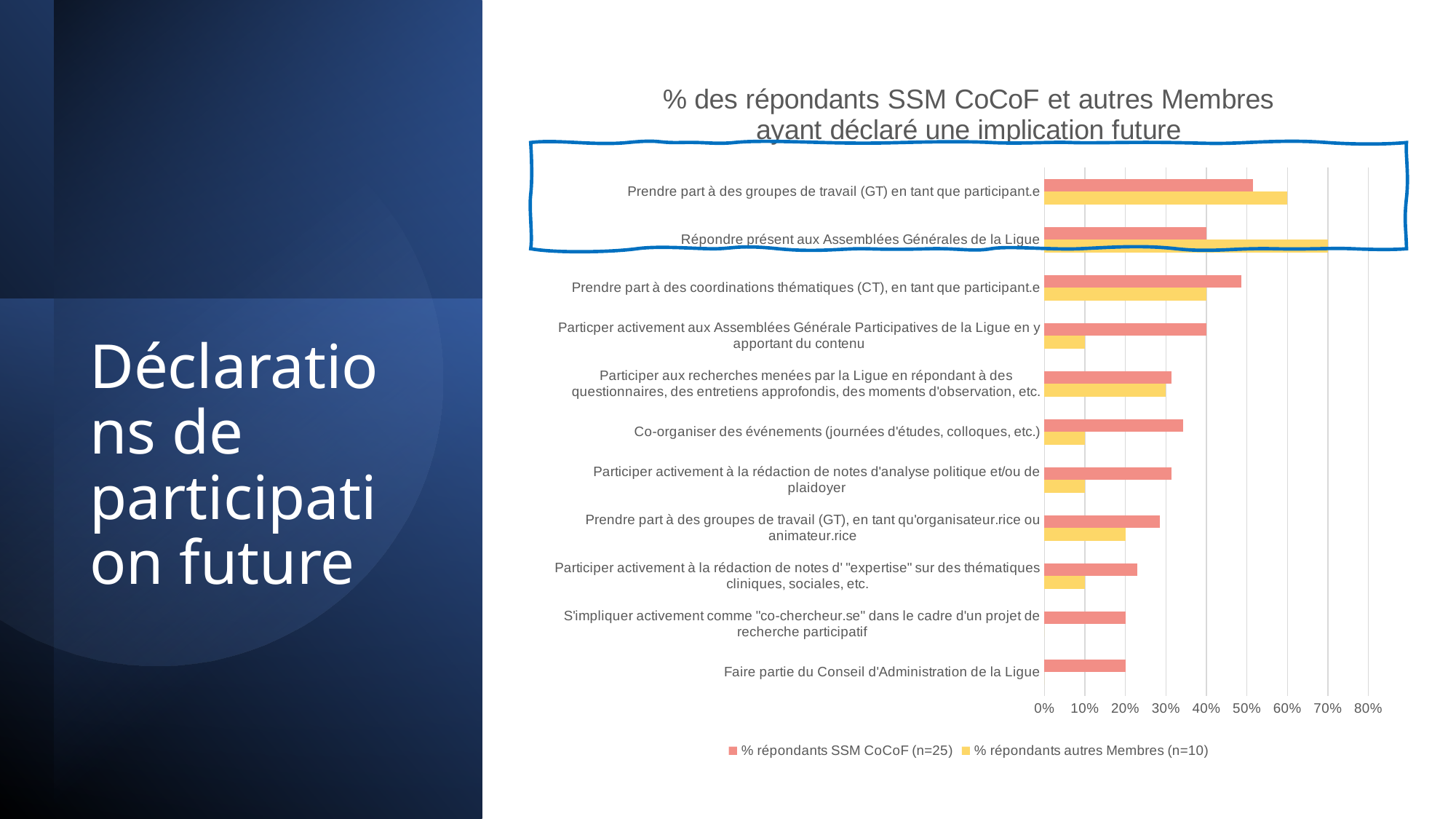
Is the '% répondants SSM CoCoF (n=25)' value for 'Prendre part à des groupes de travail (GT) en tant que participant.e' greater or less than 40%? greater What is the value for '% répondants SSM CoCoF (n=25)' for 'Faire partie du Conseil d'Administration de la Ligue'? 20% What is the value for '% répondants autres Membres (n=10)' for 'Répondre présent aux Assemblées Générales de la Ligue'? 70% How many categories (activities) are plotted in the chart? 11 How many series does the legend list? 2 What kind of chart is shown on the slide? bar chart For which category is the '% répondants autres Membres (n=10)' value highest? Répondre présent aux Assemblées Générales de la Ligue What is the value for '% répondants SSM CoCoF (n=25)' for 'Répondre présent aux Assemblées Générales de la Ligue'? 40% Is the '% répondants SSM CoCoF (n=25)' value for 'Co-organiser des événements (journées d'études, colloques, etc.)' greater or less than 30%? greater For 'Co-organiser des événements (journées d'études, colloques, etc.)', which series has the larger value? % répondants SSM CoCoF (n=25) What is the value for '% répondants autres Membres (n=10)' for 'Prendre part à des groupes de travail (GT) en tant que participant.e'? 60% What is the title of the chart? % des répondants SSM CoCoF et autres Membres ayant déclaré une implication future